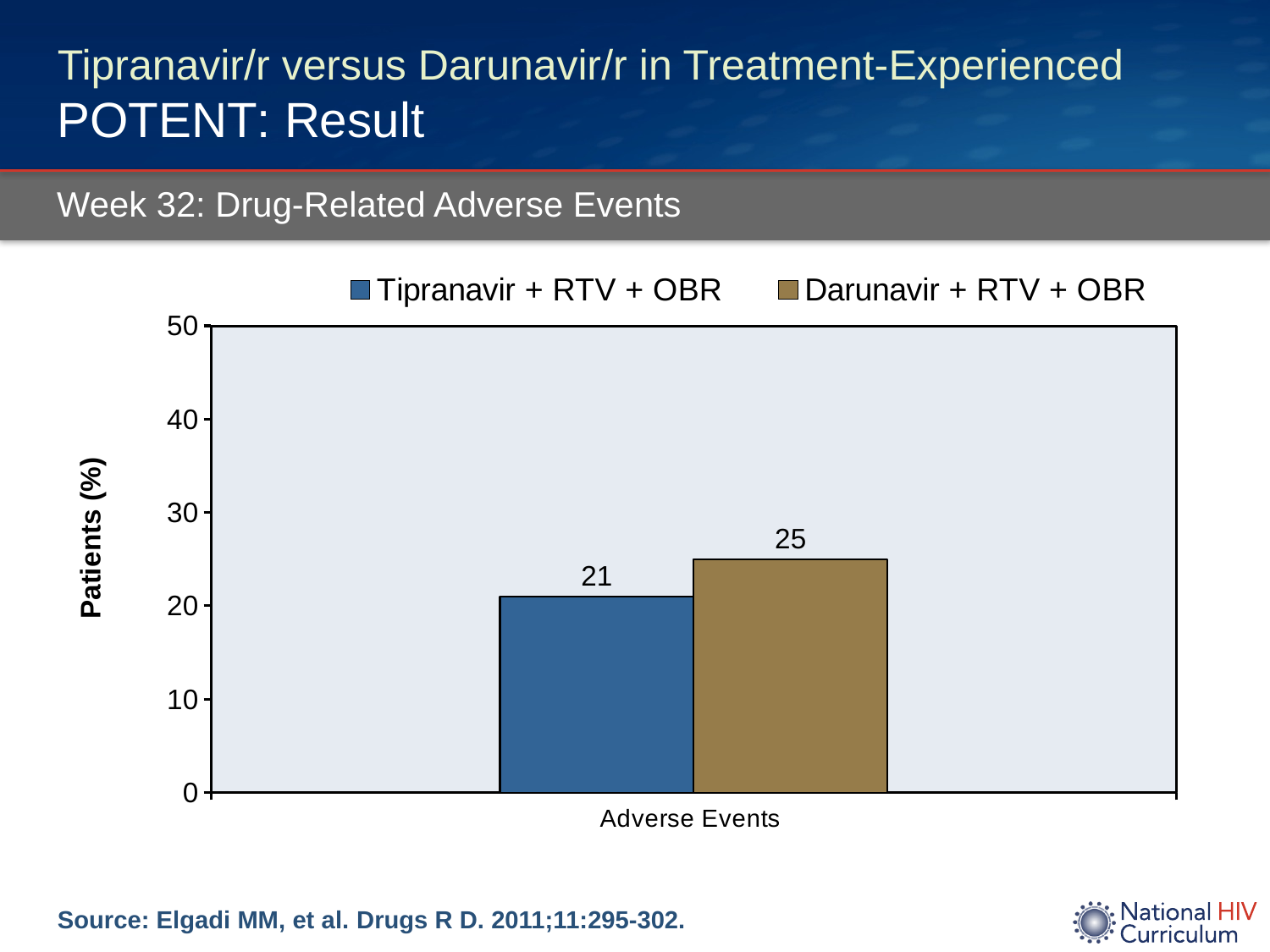
Is the value for Tipranavir + RTV + OBR greater or less than 20? greater How many series does the legend list? 2 Is the value for Tipranavir + RTV + OBR larger or smaller than the value for Darunavir + RTV + OBR? smaller What is the label of the y axis? Patients (%) What is the difference between the Darunavir + RTV + OBR and Tipranavir + RTV + OBR values? 4 Which series has the lower value for Adverse Events? Tipranavir + RTV + OBR How many categories are shown on the x axis? 1 What kind of chart is shown on the slide? bar chart Is the value for Darunavir + RTV + OBR greater or less than 30? less Which series has the higher value for Adverse Events? Darunavir + RTV + OBR What is the value for Tipranavir + RTV + OBR for Adverse Events? 21 What is the value for Darunavir + RTV + OBR for Adverse Events? 25